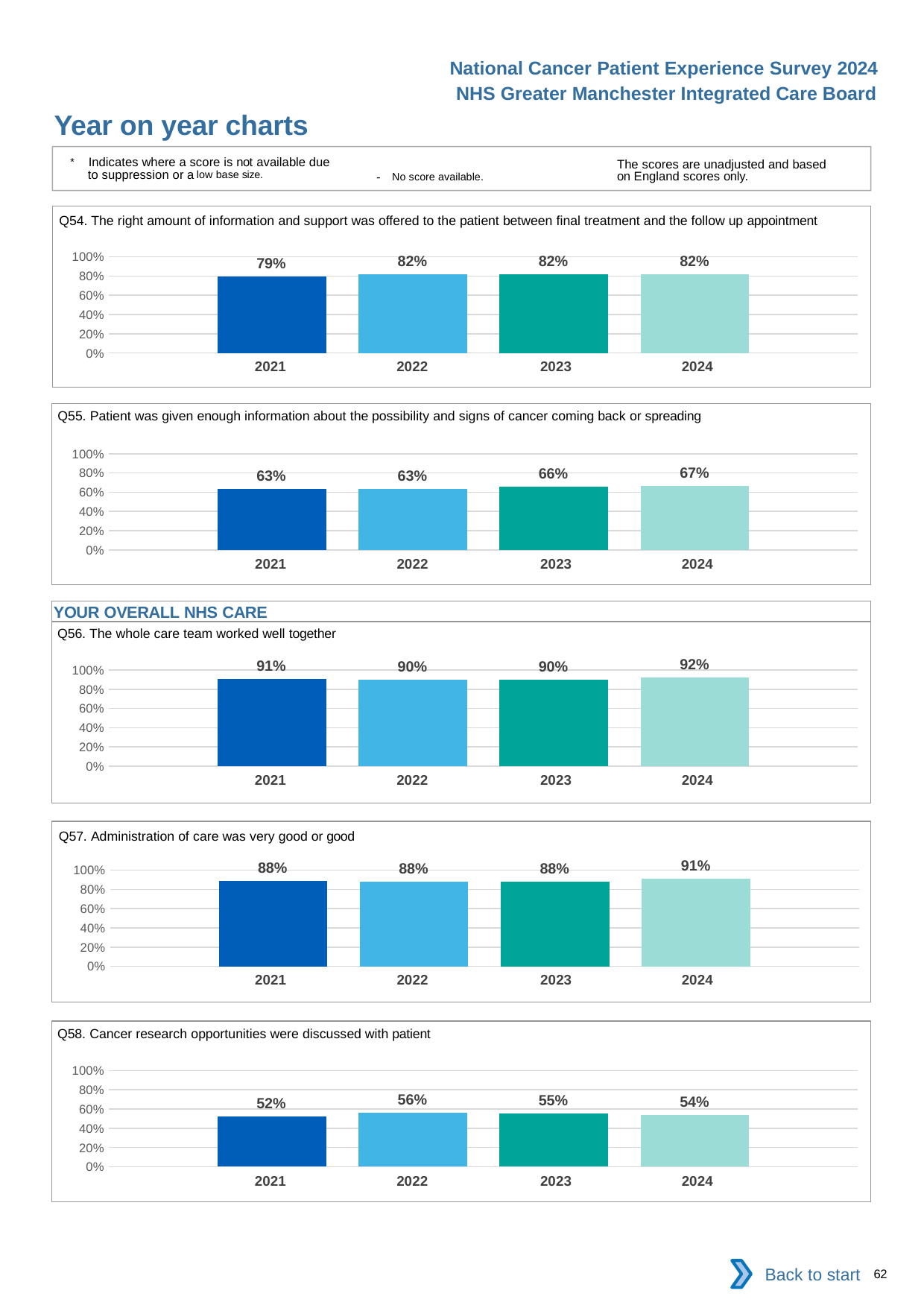
In the Q56 chart, what is the value for 2024? 92% In the Q55 chart, do the values rise or fall from 2022 to 2024? rise In the Q58 chart, which year has the lowest value? 2021 In the Q54 chart, what is the value for 2021? 79% In the Q58 chart, is the value for 2023 greater or less than 60%? less In the Q57 chart, which year has the highest value? 2024 In the Q57 chart, what is the difference between the 2024 and 2023 values? 3 percentage points In the Q55 chart, what is the difference between the 2024 and 2021 values? 4 percentage points What kind of chart is the Q56 chart? bar chart In the Q55 chart, which year has the highest value? 2024 How many years are shown in the Q54 chart? 4 In the Q58 chart, which is larger, the value for 2022 or the value for 2024? 2022